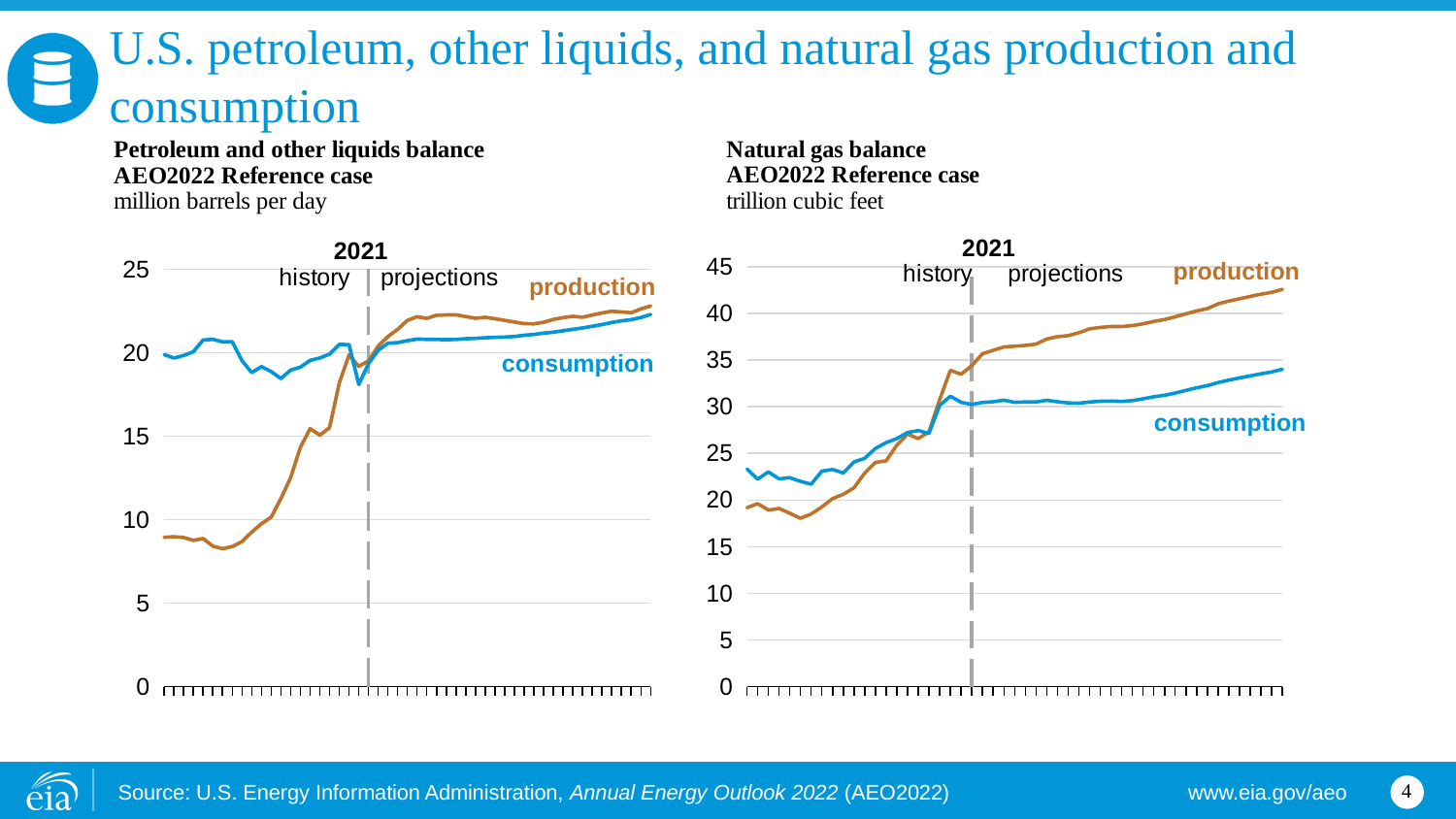
On the 'Natural gas balance' chart, which series is higher at the end of the projection period, production or consumption? production How many series are plotted on the 'Natural gas balance' chart? 2 On the 'Petroleum and other liquids balance' chart, is the production value at the start of the history period greater or less than 10? less What unit is used on the 'Petroleum and other liquids balance' chart? million barrels per day What kind of chart is the 'Petroleum and other liquids balance' chart? line chart On the 'Natural gas balance' chart, does production generally rise or fall over the projection period? rise On the 'Petroleum and other liquids balance' chart, which series is higher at the end of the projection period, production or consumption? production What year separates history from projections on both charts? 2021 On the 'Natural gas balance' chart, is the production value at the end of the projections greater or less than 40? greater What kind of chart is the 'Natural gas balance' chart? line chart On the 'Petroleum and other liquids balance' chart, is the consumption value at the start of the history period greater or less than 15? greater